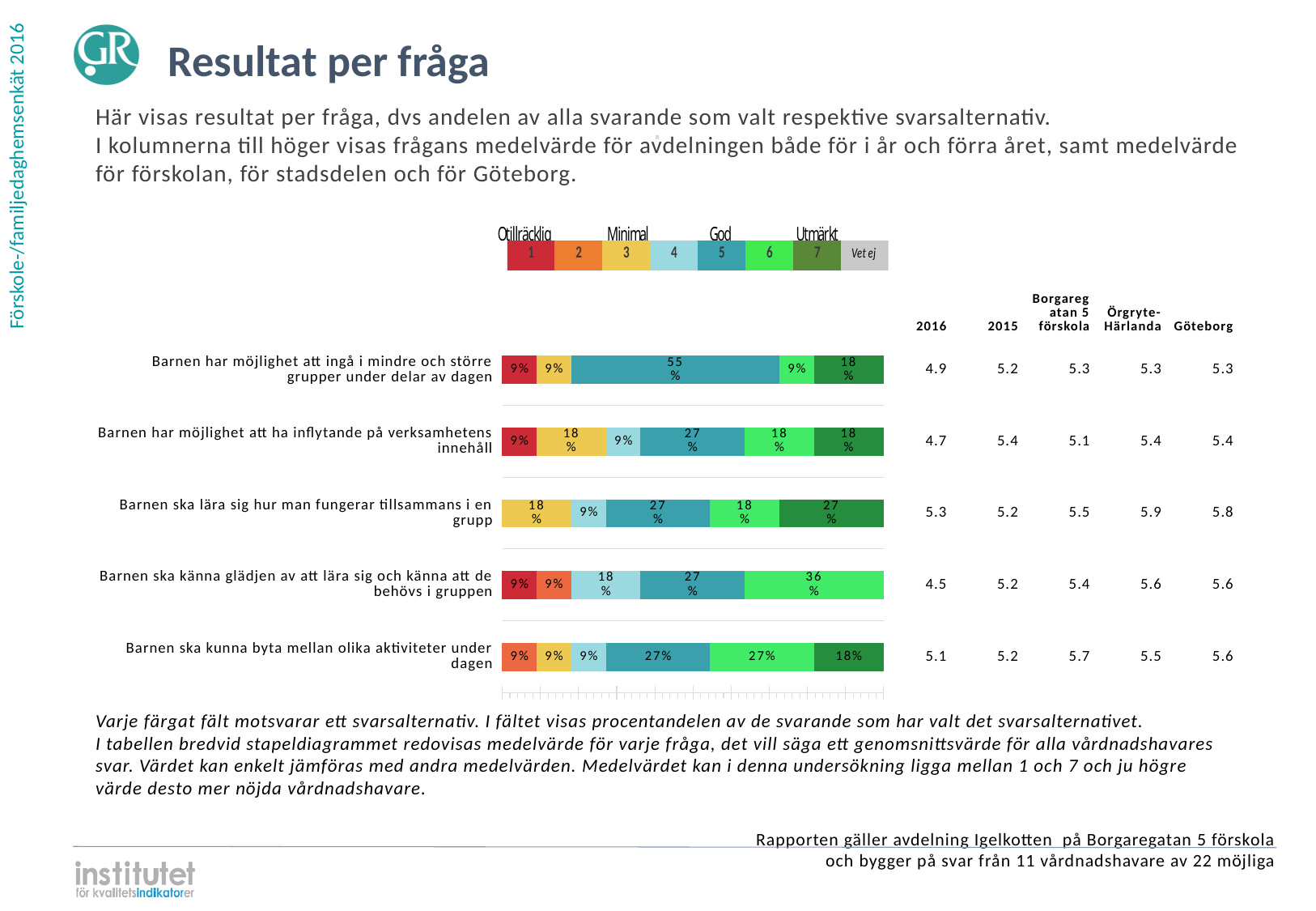
What percentage chose option 7 (dark green) for 'Barnen ska lära sig hur man fungerar tillsammans i en grupp'? 27% What percentage of respondents chose option 5 (teal) for 'Barnen har möjlighet att ingå i mindre och större grupper under delar av dagen'? 55% What is the difference between the option 5 share (55%) and the option 7 share (18%) for 'Barnen har möjlighet att ingå i mindre och större grupper under delar av dagen'? 37% How many questions (categories) are plotted in the bar chart? 5 How many answer options does the legend above the chart list? 8 For 'Barnen ska kunna byta mellan olika aktiviteter under dagen', which is larger: the option 5 share or the option 7 share? Option 5 (27%) What kind of chart is shown on the slide? Stacked bar chart What percentage chose option 3 (yellow) for 'Barnen har möjlighet att ha inflytande på verksamhetens innehåll'? 18% Which single segment in the chart has the largest percentage? 55% (option 5 for 'Barnen har möjlighet att ingå i mindre och större grupper under delar av dagen') What is the combined share of options 6 and 7 for 'Barnen ska lära sig hur man fungerar tillsammans i en grupp'? 45% What percentage chose option 6 (bright green) for 'Barnen ska känna glädjen av att lära sig och känna att de behövs i gruppen'? 36% Which label in the legend corresponds to answer option 7? Utmärkt